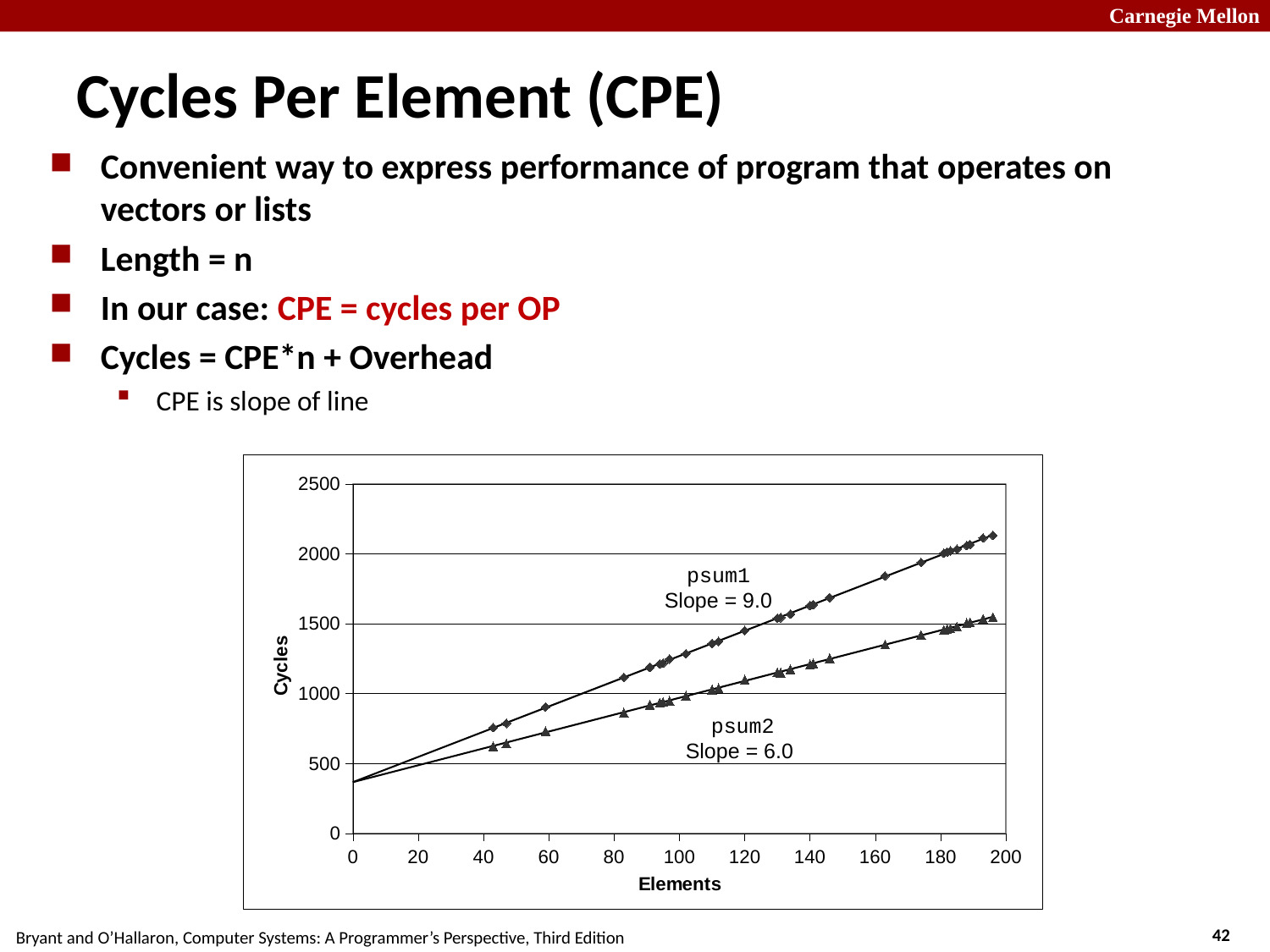
How many data series are plotted in the chart? 2 Is the psum1 value at about 195 elements greater or less than 2000 cycles? greater What is the slope of the psum1 line? 9.0 What is the label of the horizontal axis? Elements Is the psum2 value at about 195 elements greater or less than 2000 cycles? less Is the psum2 value at about 45 elements greater or less than 500 cycles? greater Which series has the steeper slope, psum1 or psum2? psum1 What is the slope of the psum2 line? 6.0 Do the Cycles values rise or fall as Elements increases? rise What is the label of the vertical axis? Cycles What kind of chart is shown on the slide? scatter chart